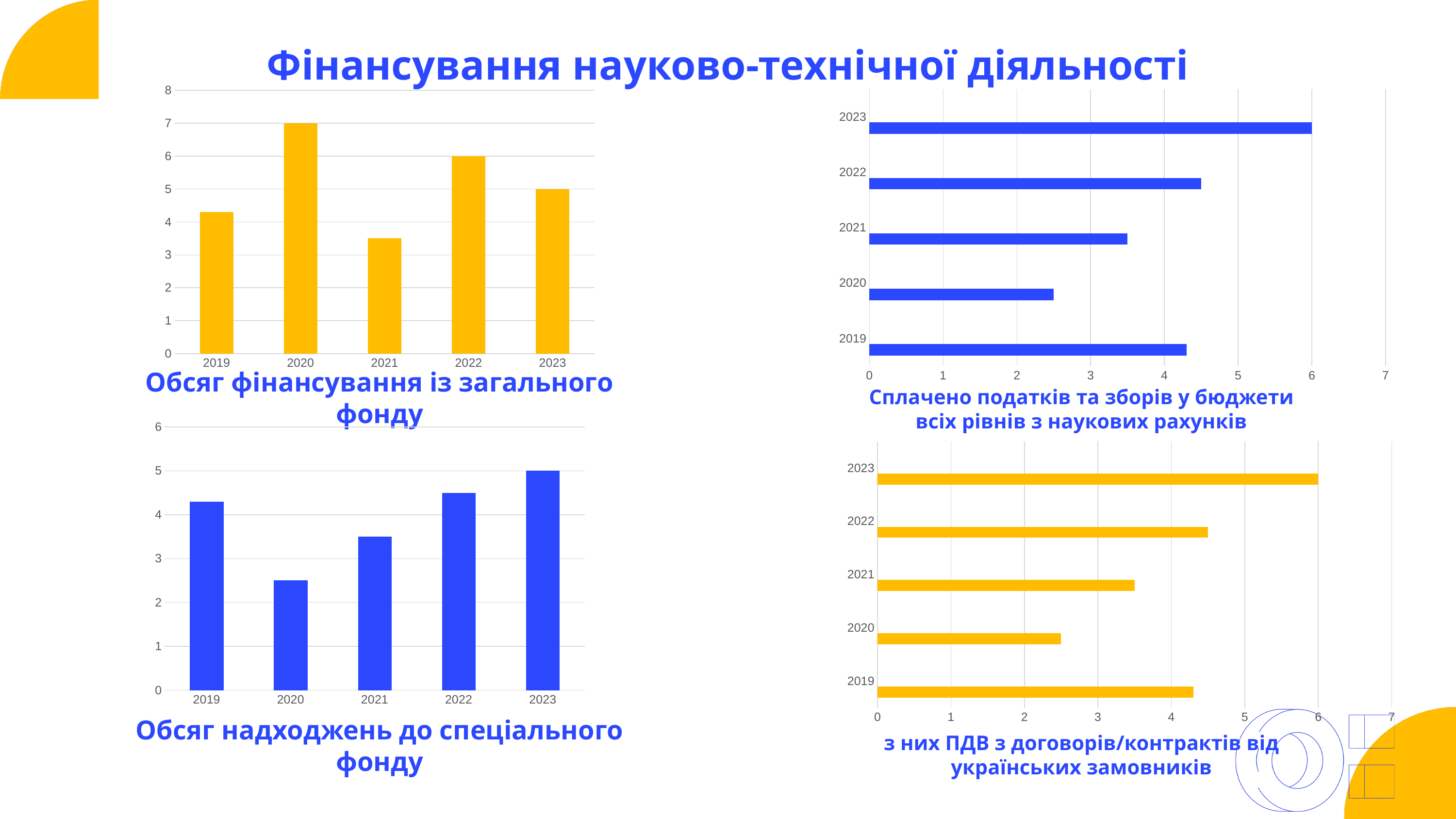
In the chart titled "Обсяг надходжень до спеціального фонду", which year has the lowest value? 2020 In the chart titled "Сплачено податків та зборів у бюджети всіх рівнів з наукових рахунків", is the value for 2022 greater or less than 4? greater In the chart titled "з них ПДВ з договорів/контрактів від українських замовників", which is larger, the value for 2021 or the value for 2022? 2022 What type of chart is the chart titled "Обсяг фінансування із загального фонду"? bar chart In the chart titled "Обсяг фінансування із загального фонду", what is the difference between the values for 2020 and 2022? 1 How many years are shown in the chart titled "з них ПДВ з договорів/контрактів від українських замовників"? 5 In the chart titled "Обсяг надходжень до спеціального фонду", what is the value for 2023? 5 In the chart titled "Обсяг надходжень до спеціального фонду", is the value for 2020 greater or less than 3? less In the chart titled "Обсяг фінансування із загального фонду", which year has the lowest value? 2021 In the chart titled "Обсяг фінансування із загального фонду", what is the value for 2020? 7 In the chart titled "Сплачено податків та зборів у бюджети всіх рівнів з наукових рахунків", which year has the highest value? 2023 In the chart titled "Обсяг фінансування із загального фонду", which year has the highest value? 2020